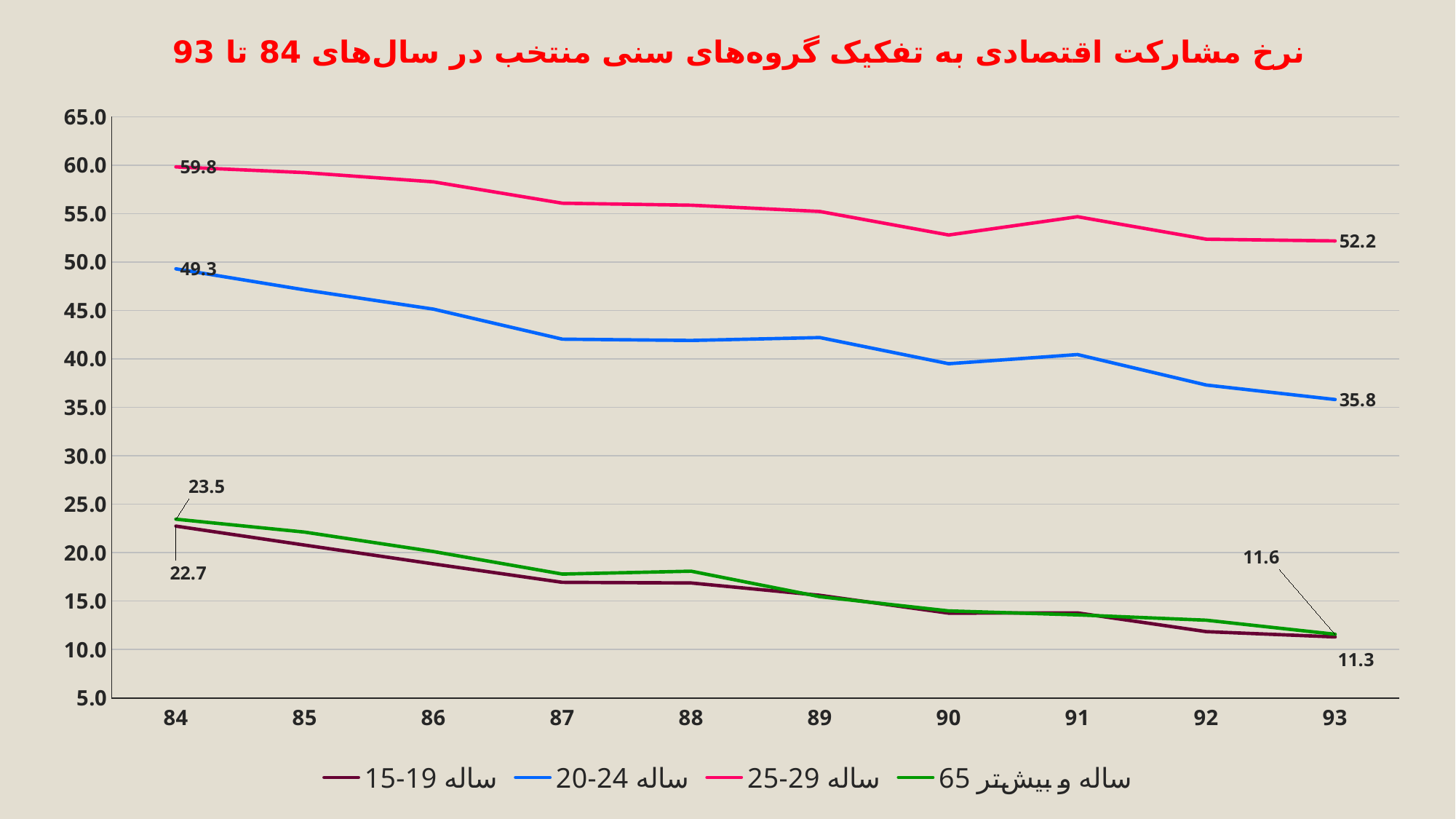
What is the value for the 20-24 ساله series in year 93? 35.8 What is the value for the 65 ساله و بیشتر series in year 84? 23.5 Is the value for the 20-24 ساله series in year 90 greater or less than 40.0? less What is the value for the 25-29 ساله series in year 93? 52.2 What kind of chart is shown on the slide? line chart How many years are shown along the x axis? 10 How many series does the legend list? 4 What is the value for the 15-19 ساله series in year 93? 11.3 What is the value for the 25-29 ساله series in year 84? 59.8 By how much did the 20-24 ساله series fall from year 84 to year 93? 13.5 What is the value for the 20-24 ساله series in year 84? 49.3 Which series has the highest values across all years? 25-29 ساله